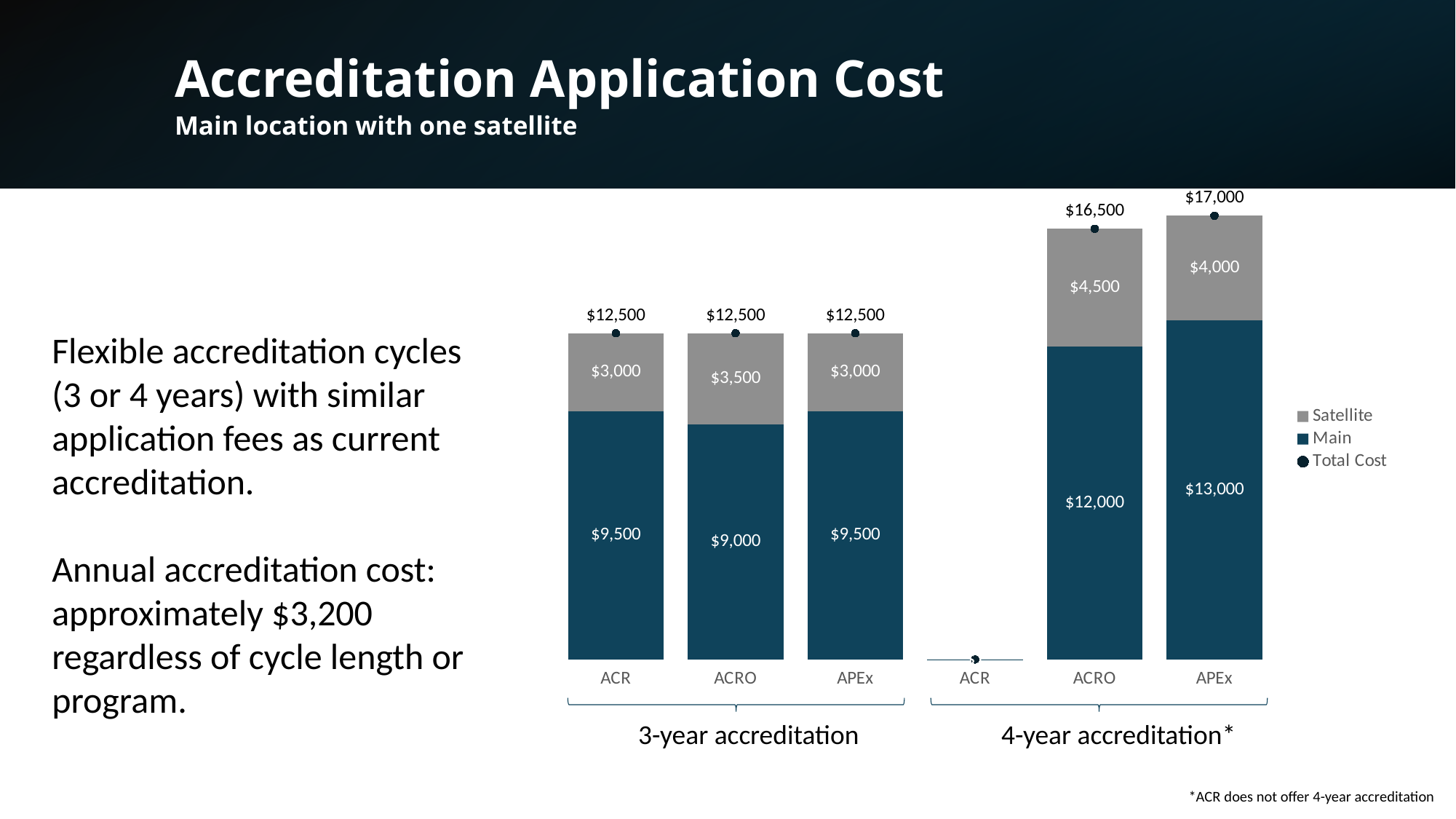
How many series does the legend list? 3 Which bar has the highest Total Cost? APEx (4-year accreditation) What is the Total Cost for APEx under 4-year accreditation? $17,000 Which legend entry is shown in grey? Satellite Which program has the lowest Main cost among the 3-year accreditation bars? ACRO What is the total of the stacked bar for APEx under 4-year accreditation? $17,000 What is the Satellite cost for ACRO under 4-year accreditation? $4,500 What is the difference between the Total Cost for ACRO under 4-year accreditation and ACRO under 3-year accreditation? $4,000 What kind of chart is shown on the slide? Stacked bar chart Which is larger: the Satellite cost for ACRO under 4-year accreditation or the Satellite cost for APEx under 4-year accreditation? ACRO (4-year accreditation) What is the Main cost for ACRO under 3-year accreditation? $9,000 What is the Main cost for APEx under 3-year accreditation? $9,500